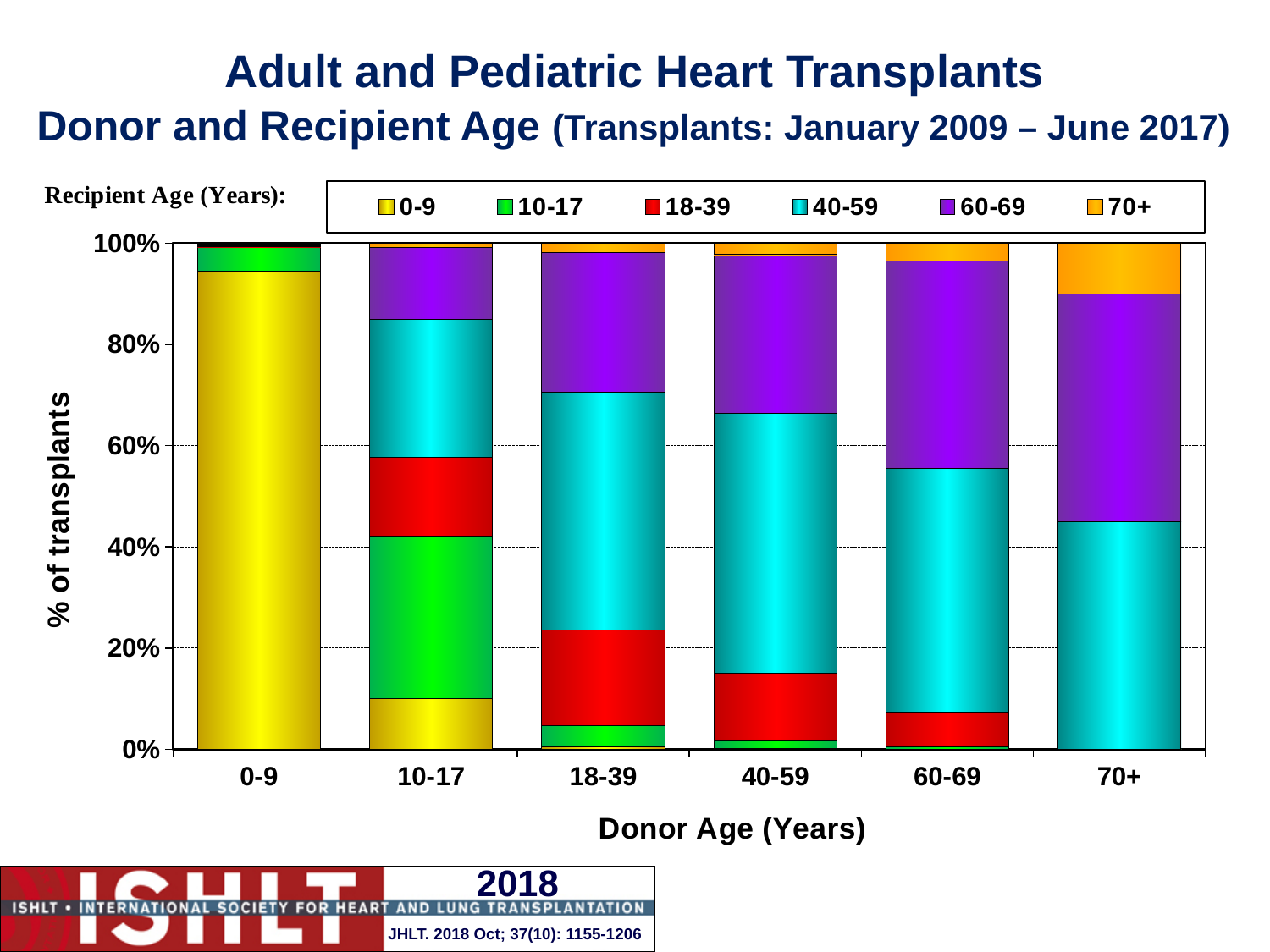
What is the total height of each stacked bar? 100% How many recipient age groups does the legend list? 6 What kind of chart is shown on the slide? Stacked bar chart Which donor age group has the largest share of recipients aged 70+? 70+ For donor age 40-59, is the share of recipients aged 18-39 greater or less than 20%? less How many donor age groups are shown along the x axis? 6 Does the share of recipients aged 0-9 rise or fall as donor age increases along the x axis? fall For donor age 70+, is the share of recipients aged 40-59 greater or less than 40%? greater What is the label of the y axis? % of transplants For donor age 18-39, which recipient age group has the larger share: 40-59 or 60-69? 40-59 For donor age 0-9, is the share of recipients aged 0-9 greater or less than 80%? greater Which donor age group has the largest share of recipients aged 0-9? 0-9